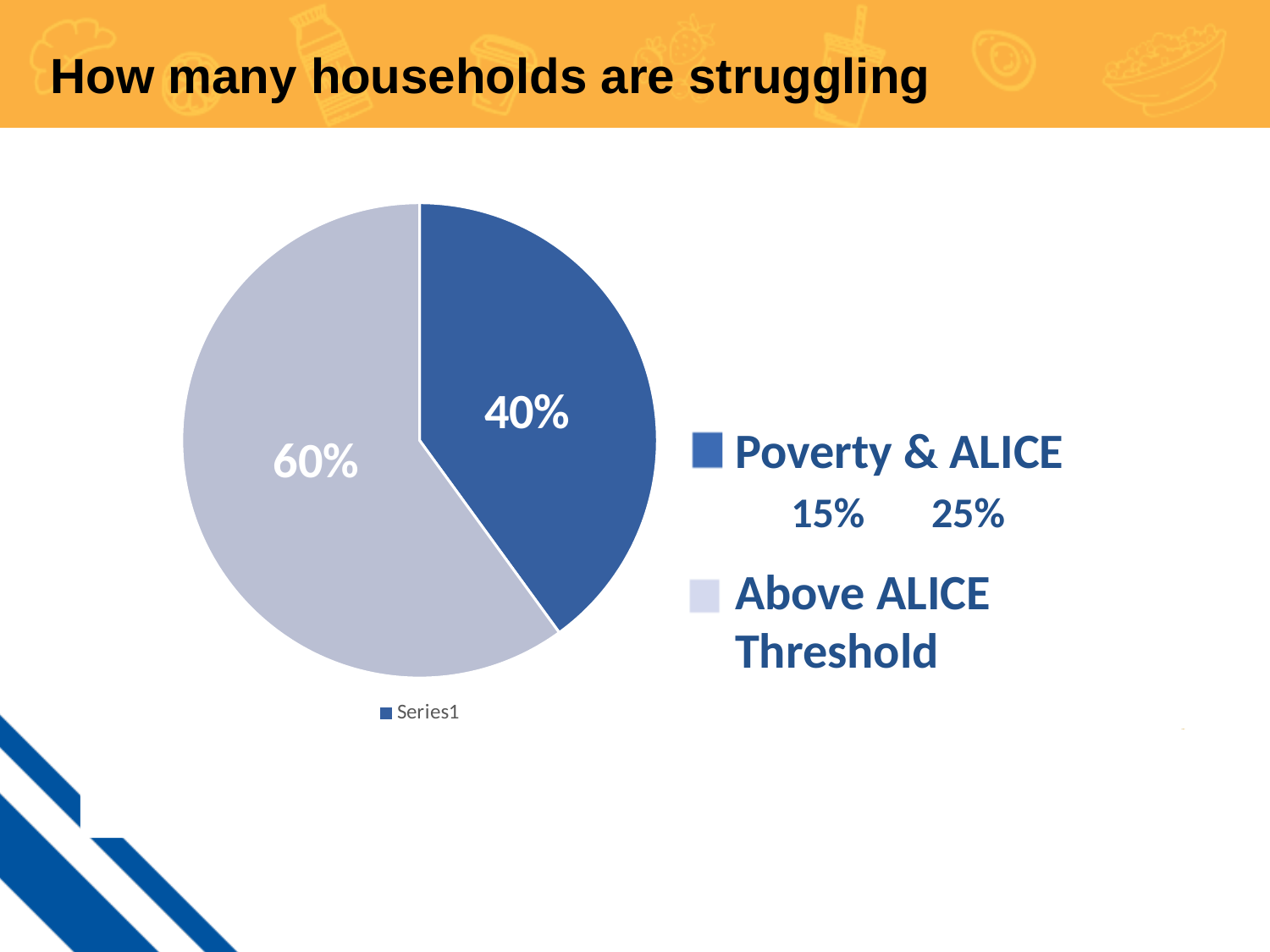
Is the Poverty & ALICE slice greater or less than 50% of the pie? less What is the difference in percentage points between the Above ALICE Threshold slice and the Poverty & ALICE slice? 20 Which is larger, the Poverty & ALICE slice or the Above ALICE Threshold slice? Above ALICE Threshold Which slice of the pie is the smallest? Poverty & ALICE How many slices does the pie chart have? 2 What share of the pie does the Above ALICE Threshold slice represent? 60% What series name appears in the legend below the pie chart? Series1 Which slice of the pie is the largest? Above ALICE Threshold What kind of chart is shown on the slide? Pie chart What is the title of the slide containing the pie chart? How many households are struggling Is the Above ALICE Threshold slice greater or less than 50% of the pie? greater What share of the pie does the Poverty & ALICE slice represent? 40%